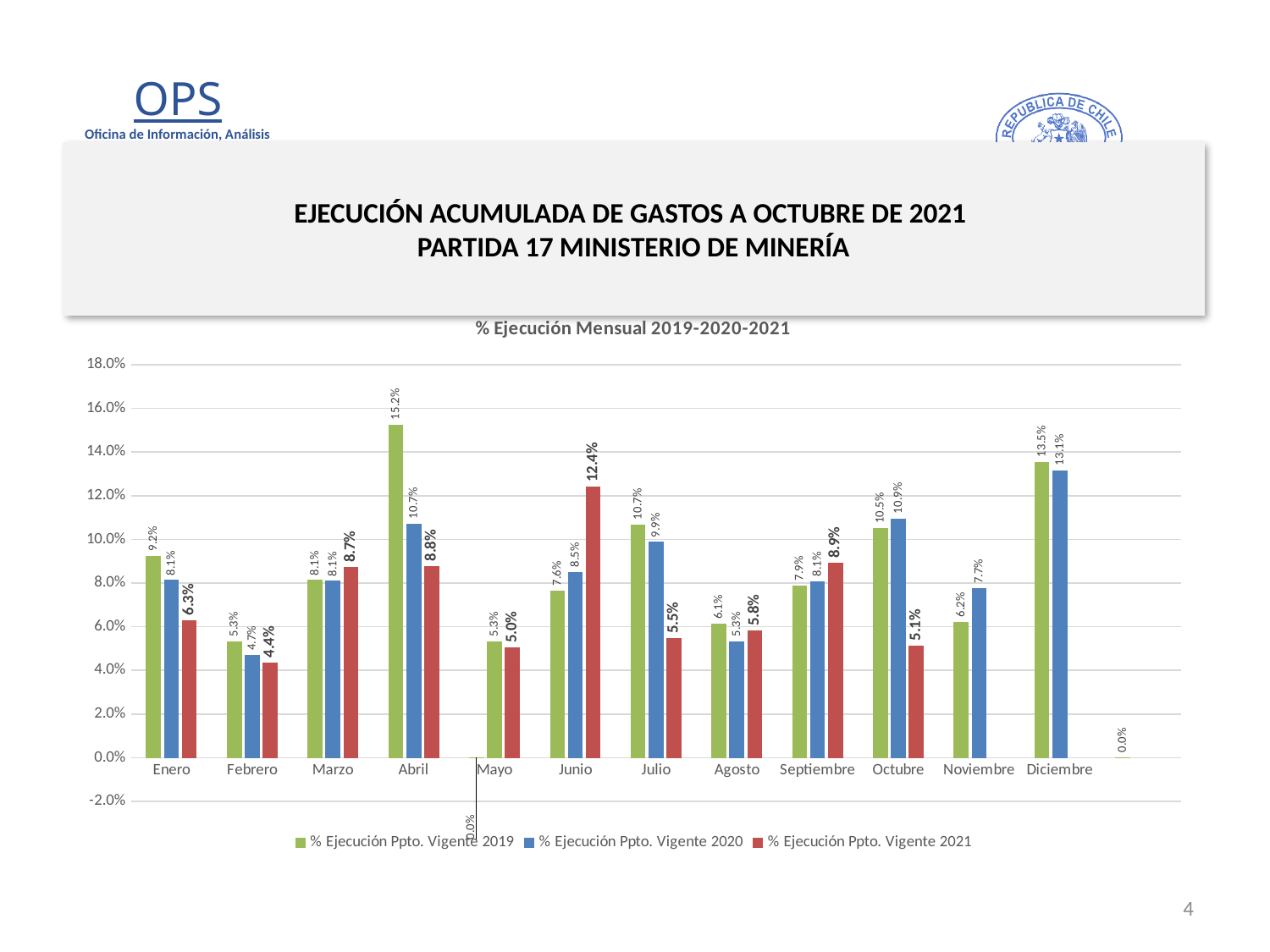
How many series does the legend list? 3 What is the value for % Ejecución Ppto. Vigente 2020 in Octubre? 10.9% What is the value for % Ejecución Ppto. Vigente 2021 in Junio? 12.4% Is the value for % Ejecución Ppto. Vigente 2019 in Diciembre greater or less than 12.0%? greater What is the difference between the 2019 and 2020 values in Abril? 4.5% Which month has the lowest value for % Ejecución Ppto. Vigente 2021 among Enero to Octubre? Febrero Which month has the highest value for % Ejecución Ppto. Vigente 2019? Abril What is the title of the chart? % Ejecución Mensual 2019-2020-2021 How many months are shown on the x axis? 12 What kind of chart is shown on the slide? Bar chart What is the value for % Ejecución Ppto. Vigente 2019 in Abril? 15.2% In Julio, which is larger: the 2019 value or the 2021 value? 2019